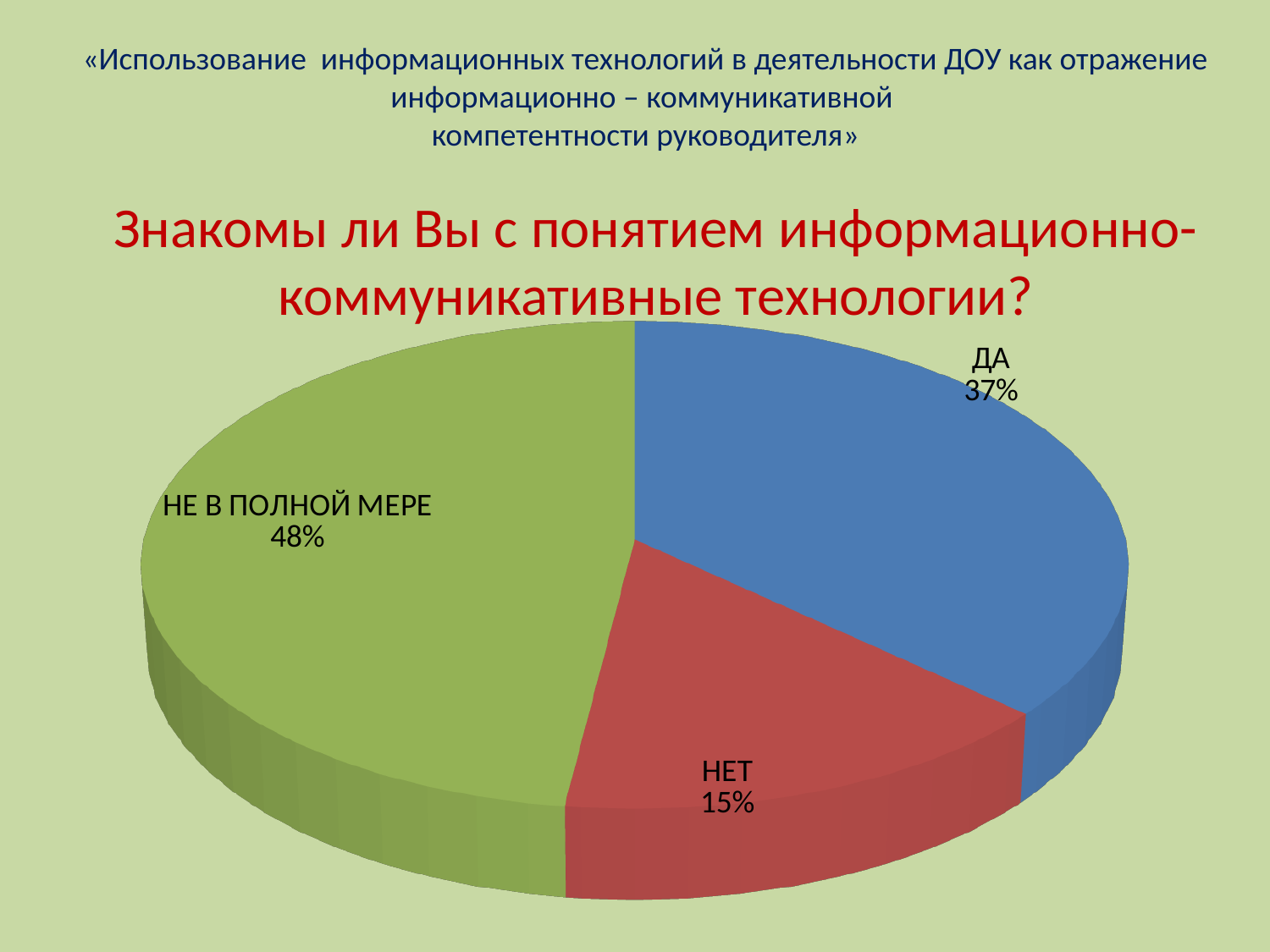
Which answer has the largest share of the pie? НЕ В ПОЛНОЙ МЕРЕ What colour is the slice for ДА? blue What is the difference in percentage points between НЕ В ПОЛНОЙ МЕРЕ and ДА? 11 What percentage of respondents answered НЕ В ПОЛНОЙ МЕРЕ? 48% Which answer has the smallest share of the pie? НЕТ How many slices does the pie chart have? 3 What percentage of respondents answered НЕТ? 15% What colour is the slice for НЕТ? red What percentage of respondents answered ДА? 37% What type of chart is shown on the slide? pie chart What is the difference in percentage points between ДА and НЕТ? 22 Which is larger, the share for ДА or the share for НЕТ? ДА